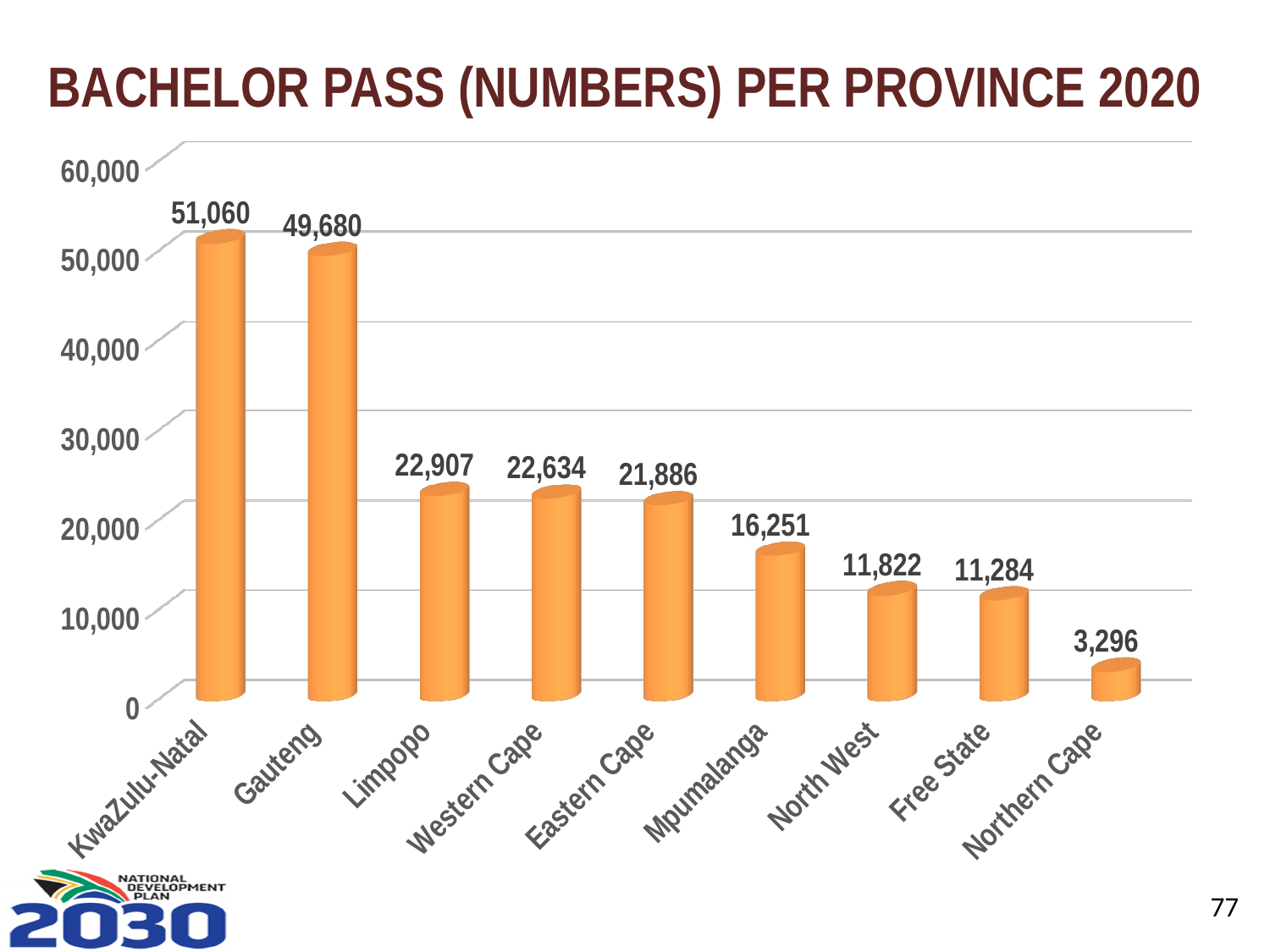
Is the value for Mpumalanga greater or less than 20,000? less What is the difference in bachelor passes between KwaZulu-Natal and Gauteng? 1,380 Which province has the highest number of bachelor passes? KwaZulu-Natal What is the number of bachelor passes for KwaZulu-Natal? 51,060 What is the number of bachelor passes for Mpumalanga? 16,251 Which province has the lowest number of bachelor passes? Northern Cape What is the difference in bachelor passes between North West and Free State? 538 What is the number of bachelor passes for Northern Cape? 3,296 What kind of chart is shown on the slide? bar chart What is the title of the chart? BACHELOR PASS (NUMBERS) PER PROVINCE 2020 Which has more bachelor passes, Limpopo or Eastern Cape? Limpopo How many provinces are shown in the chart? 9